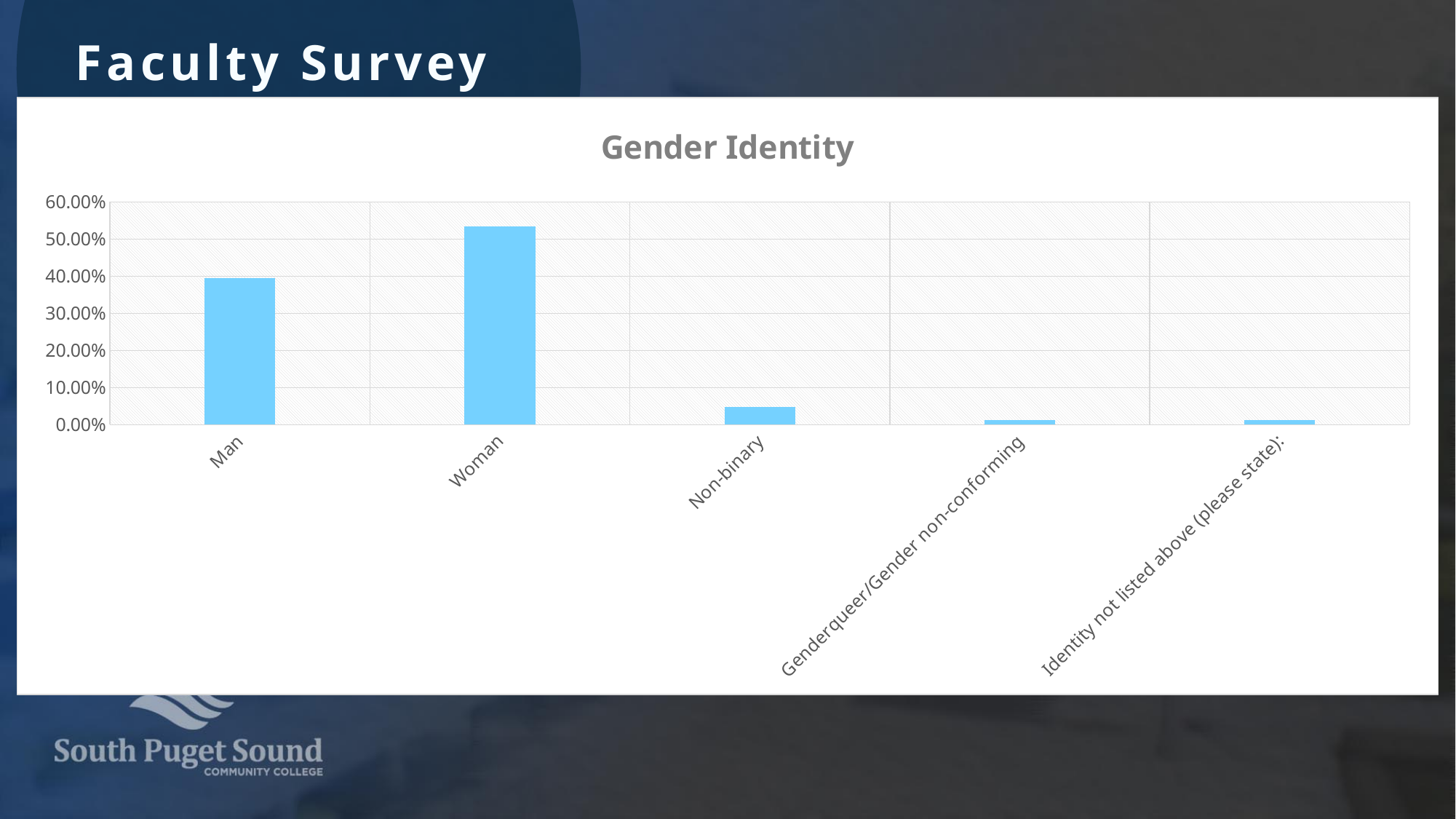
Is the value for Man greater or less than 30.00%? greater Is the value for Woman greater or less than 50.00%? greater What is the title of the chart? Gender Identity What is the highest value shown on the y axis of the chart? 60.00% What type of chart is shown on the slide? bar chart Is the value for Genderqueer/Gender non-conforming greater or less than 10.00%? less Which is larger, the value for Man or the value for Woman? Woman Which category has the highest value in the chart? Woman How many categories are shown on the x axis of the chart? 5 Which is larger, the value for Non-binary or the value for Man? Man